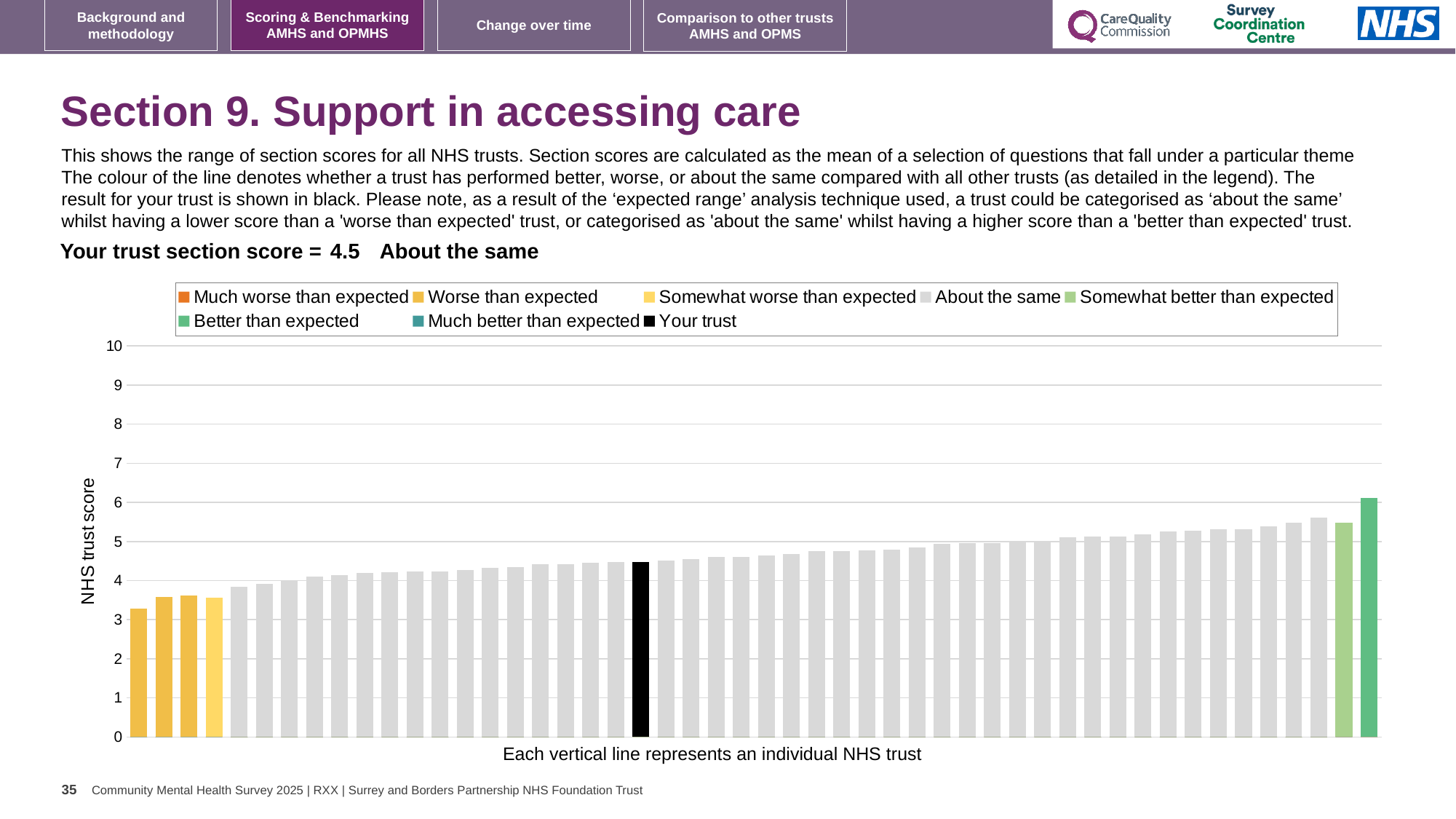
Which legend category does the shortest bar belong to? Worse than expected Which legend category does the tallest bar belong to? Better than expected What is the label on the vertical axis? NHS trust score Is the value for your trust (the black bar) greater or less than 4? greater How many entries does the chart legend list? 8 Is the value for the lowest bar greater or less than 4? less How many bars are coloured as 'Better than expected'? 1 Which performance category is your trust placed in? About the same What is the section score for your trust? 4.5 Do the bar values rise or fall from left to right along the x axis? rise Is the value for the highest bar greater or less than 5? greater What kind of chart is shown on the slide? bar chart